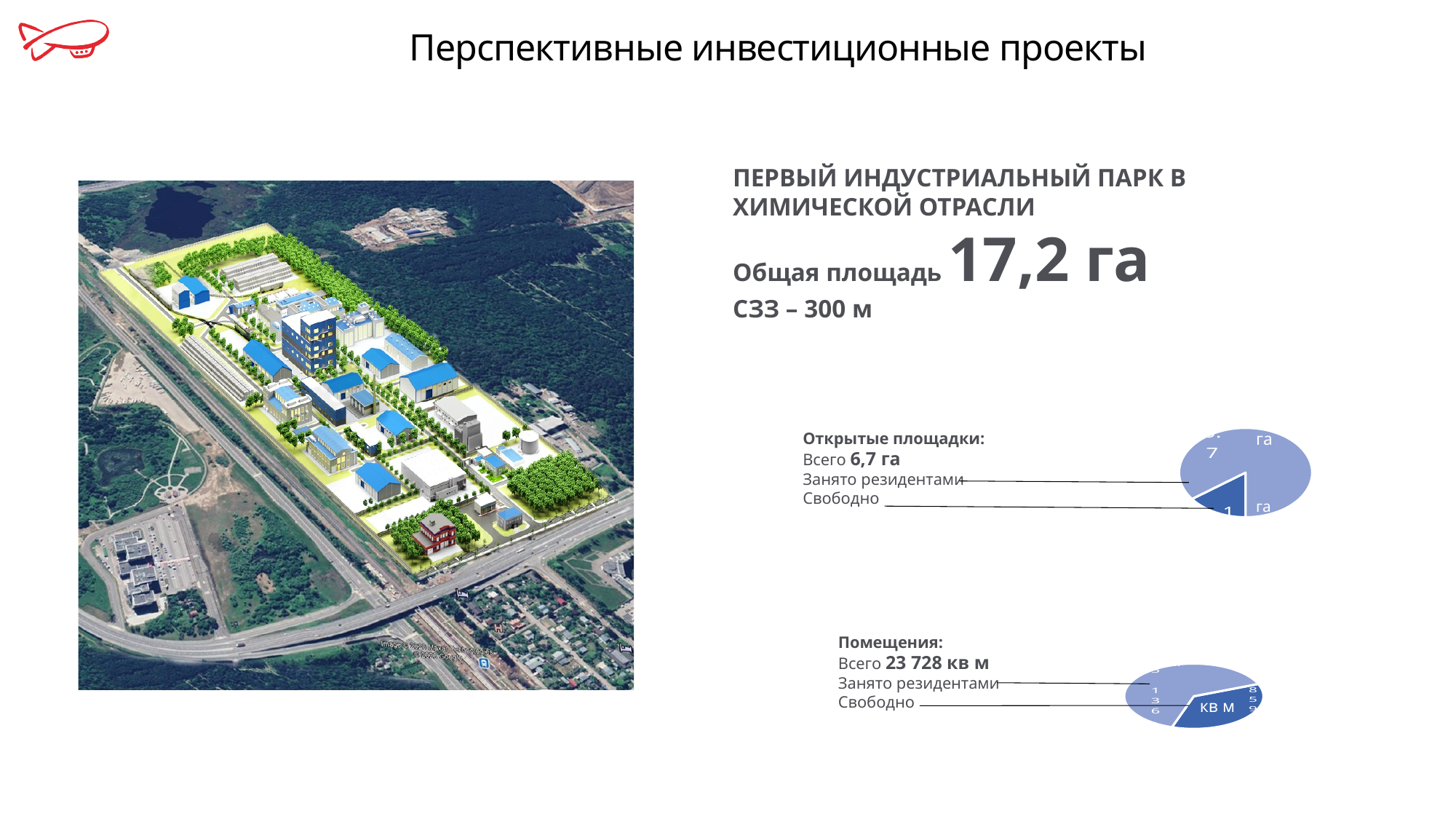
In the "Помещения" chart, which slice is larger: Занято резидентами or Свободно? Занято резидентами How many slices does the "Открытые площадки" pie chart have? 2 In the "Открытые площадки" chart, which category has the smallest share? Свободно What kind of chart is the "Помещения" chart? pie chart How many slices does the "Помещения" pie chart have? 2 What total is stated next to the "Открытые площадки" pie chart? 6,7 га In the "Открытые площадки" chart, which category has the largest share? Занято резидентами What kind of chart is the "Открытые площадки" chart? pie chart What total is stated next to the "Помещения" pie chart? 23 728 кв м In the "Помещения" chart, which category has the smallest share? Свободно In the "Открытые площадки" chart, which slice is larger: Занято резидентами or Свободно? Занято резидентами